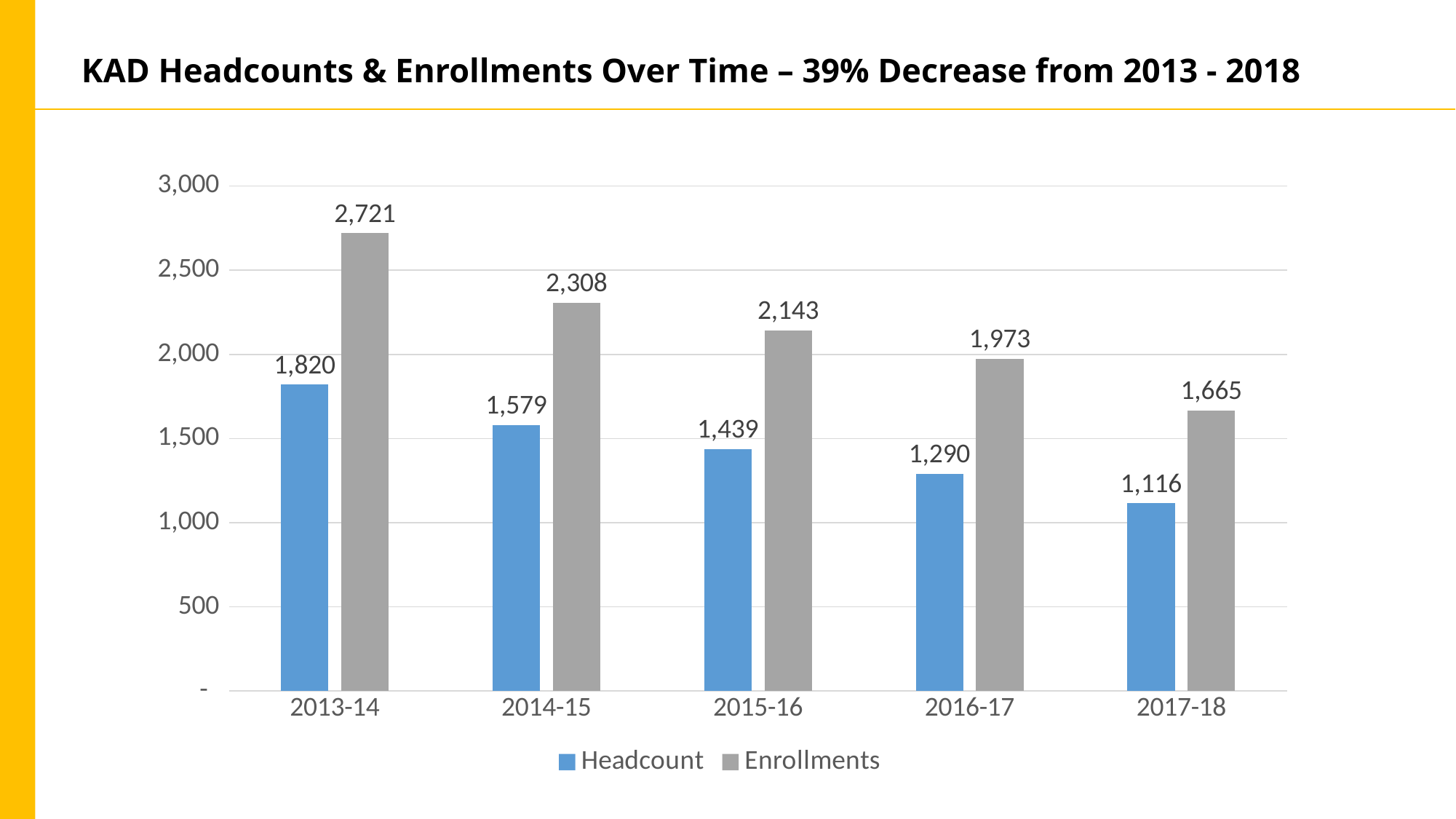
Which year has the lowest Headcount value? 2017-18 What is the Enrollments value for 2017-18? 1,665 How many years are shown on the x axis? 5 Do the Enrollments values rise or fall from 2013-14 to 2017-18? Fall How many series does the legend list? 2 Which is larger, the Headcount in 2014-15 or the Enrollments in 2017-18? Enrollments in 2017-18 What is the Enrollments value for 2015-16? 2,143 Which year has the highest Enrollments value? 2013-14 What kind of chart is shown on the slide? Bar chart What is the difference between Enrollments and Headcount in 2016-17? 683 What is the difference between the Headcount in 2013-14 and the Headcount in 2017-18? 704 What is the Headcount value for 2013-14? 1,820